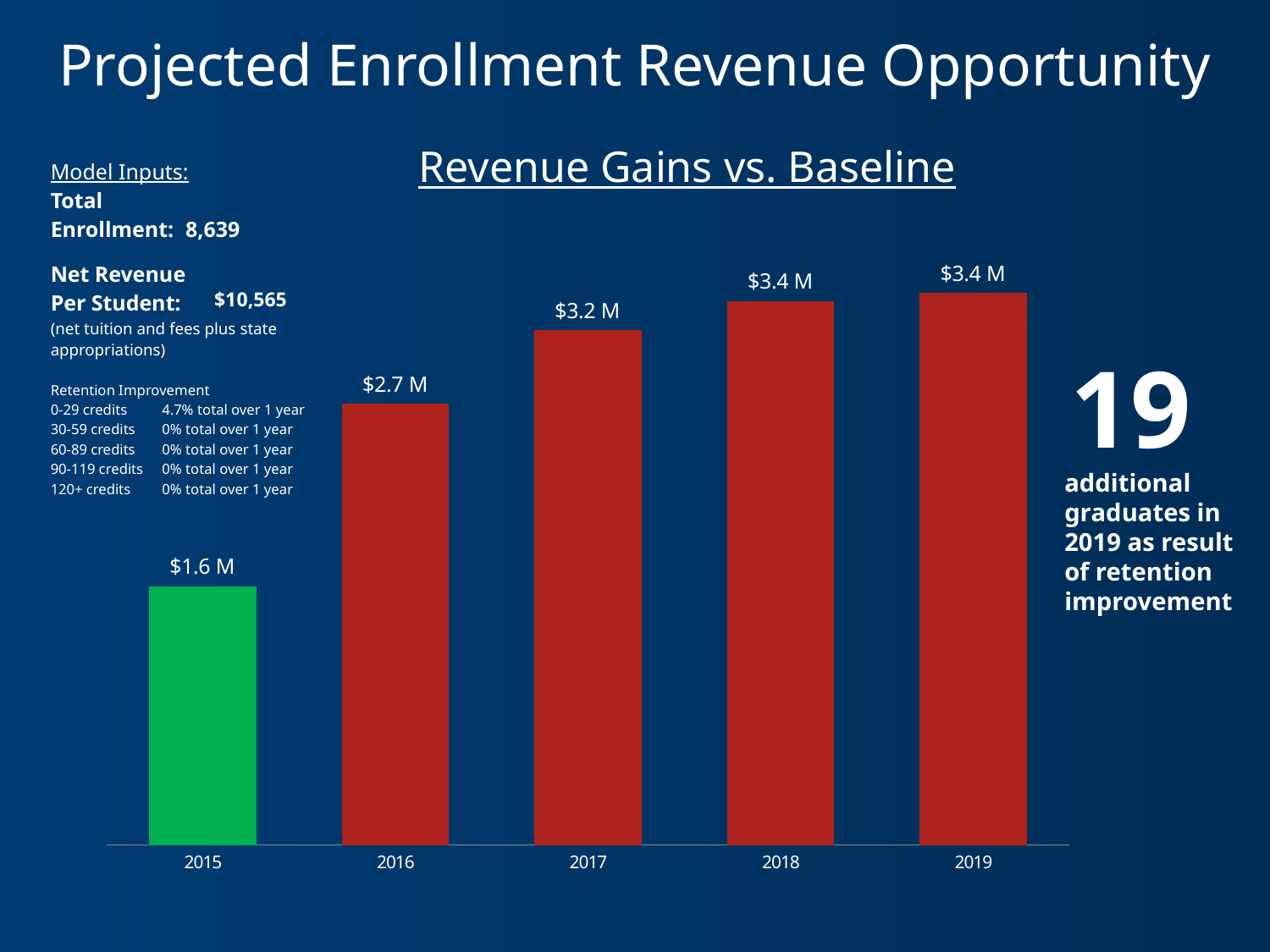
What is the revenue gain shown for 2016? $2.7 M How many years are shown on the x axis of the chart? 5 Do the revenue gains rise or fall from 2015 to 2019? rise What kind of chart is shown on the slide? bar chart What is the difference between the revenue gain in 2016 and in 2015? $1.1 M Which year's bar is coloured green rather than red? 2015 What is the title of the chart? Revenue Gains vs. Baseline What is the revenue gain shown for 2015? $1.6 M What is the difference between the revenue gain in 2017 and in 2015? $1.6 M Which year has the lowest revenue gain? 2015 Which is larger, the revenue gain in 2016 or in 2017? 2017 What is the revenue gain shown for 2017? $3.2 M